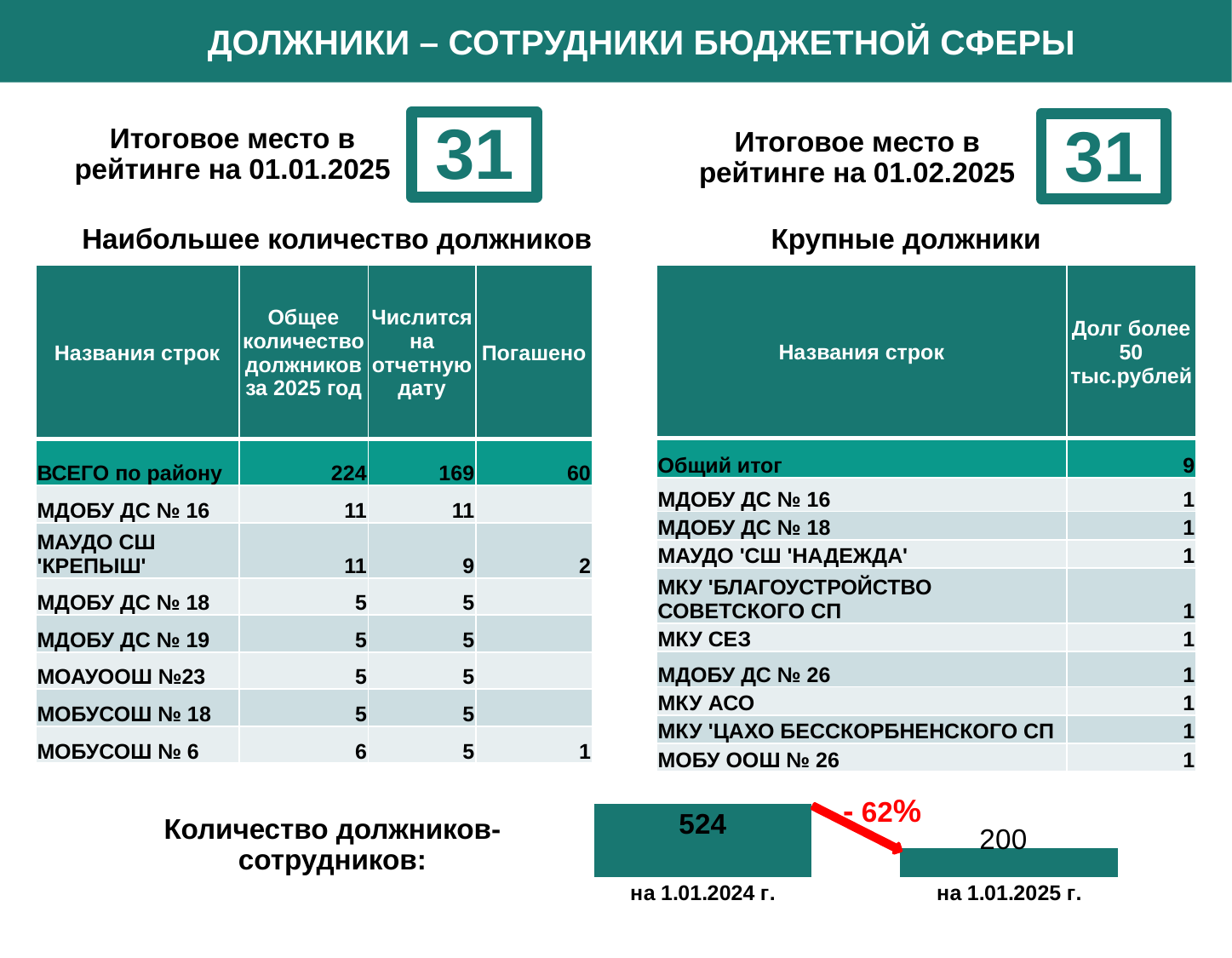
In the bar chart at the bottom of the slide, which date has the lower value? на 1.01.2025 г. How many bars are shown in the chart at the bottom of the slide? 2 In the bar chart at the bottom of the slide, what is the value for на 1.01.2025 г.? 200 What is the label to the left of the bar chart at the bottom of the slide? Количество должников-сотрудников: In the bar chart at the bottom of the slide, what is the value for на 1.01.2024 г.? 524 In the bar chart at the bottom of the slide, do the values rise or fall from на 1.01.2024 г. to на 1.01.2025 г.? fall What percentage change is annotated in red on the bar chart at the bottom of the slide? - 62% In the bar chart at the bottom of the slide, which date has the higher value? на 1.01.2024 г. In the bar chart at the bottom of the slide, what is the difference between the value for на 1.01.2024 г. and the value for на 1.01.2025 г.? 324 In the bar chart at the bottom of the slide, is the value for на 1.01.2024 г. larger or smaller than the value for на 1.01.2025 г.? larger What kind of chart is shown at the bottom of the slide? bar chart